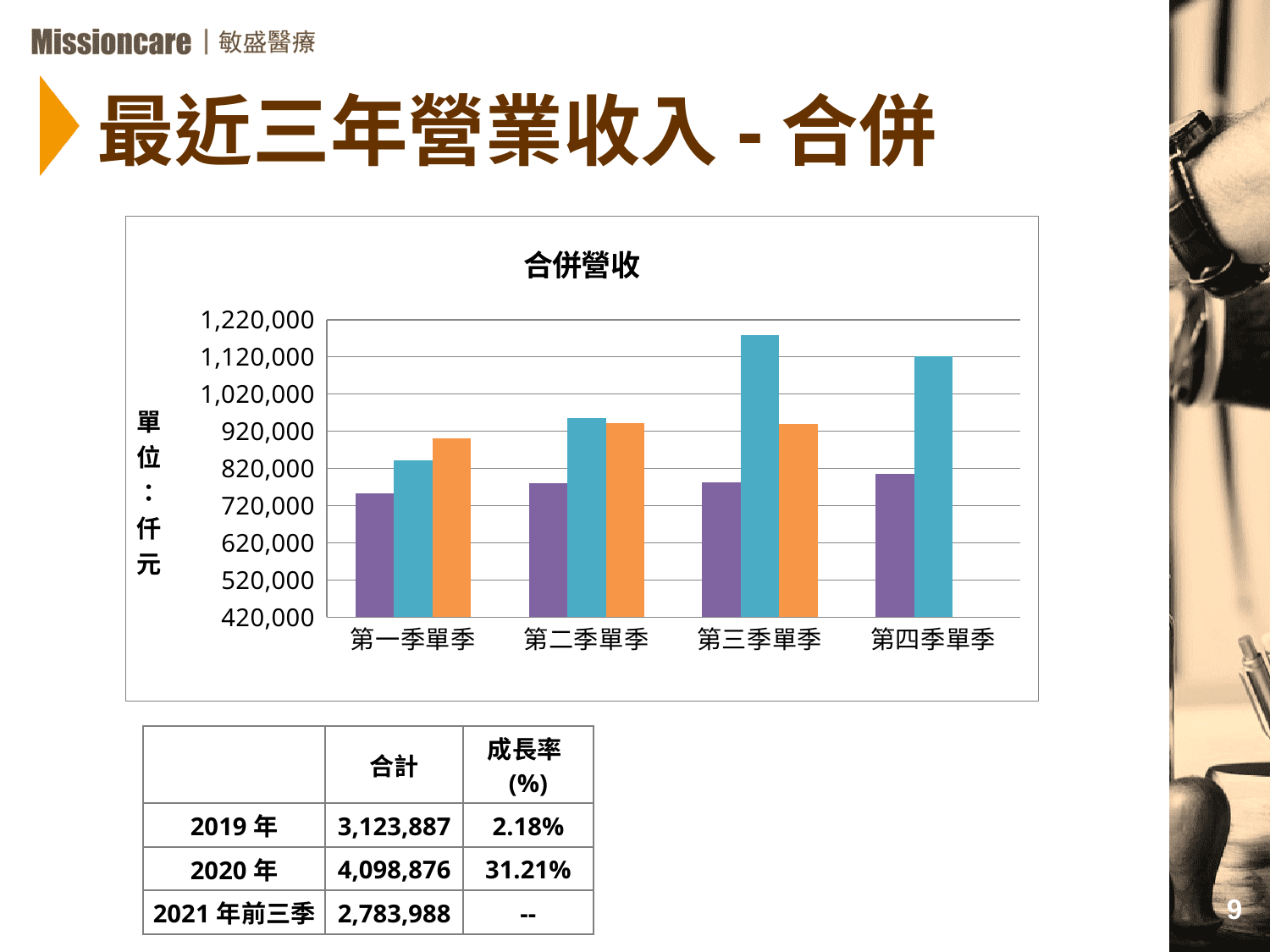
Is the value of the teal bar for 第三季單季 greater or less than 1,120,000? greater Do the purple bars rise or fall from 第一季單季 to 第四季單季? rise Which quarter contains the shortest bar in the chart? 第一季單季 Is the value of the teal bar for 第二季單季 greater or less than 920,000? greater What is the title of the chart? 合併營收 Is the value of the purple bar for 第一季單季 greater or less than 820,000? less How many bars are plotted for 第四季單季? 2 How many quarter categories are shown on the x axis of the chart? 4 What unit is given for the y axis of the chart? 仟元 In 第三季單季, which is larger, the teal bar or the orange bar? the teal bar Which quarter contains the tallest bar in the chart? 第三季單季 What kind of chart is shown on the slide? bar chart